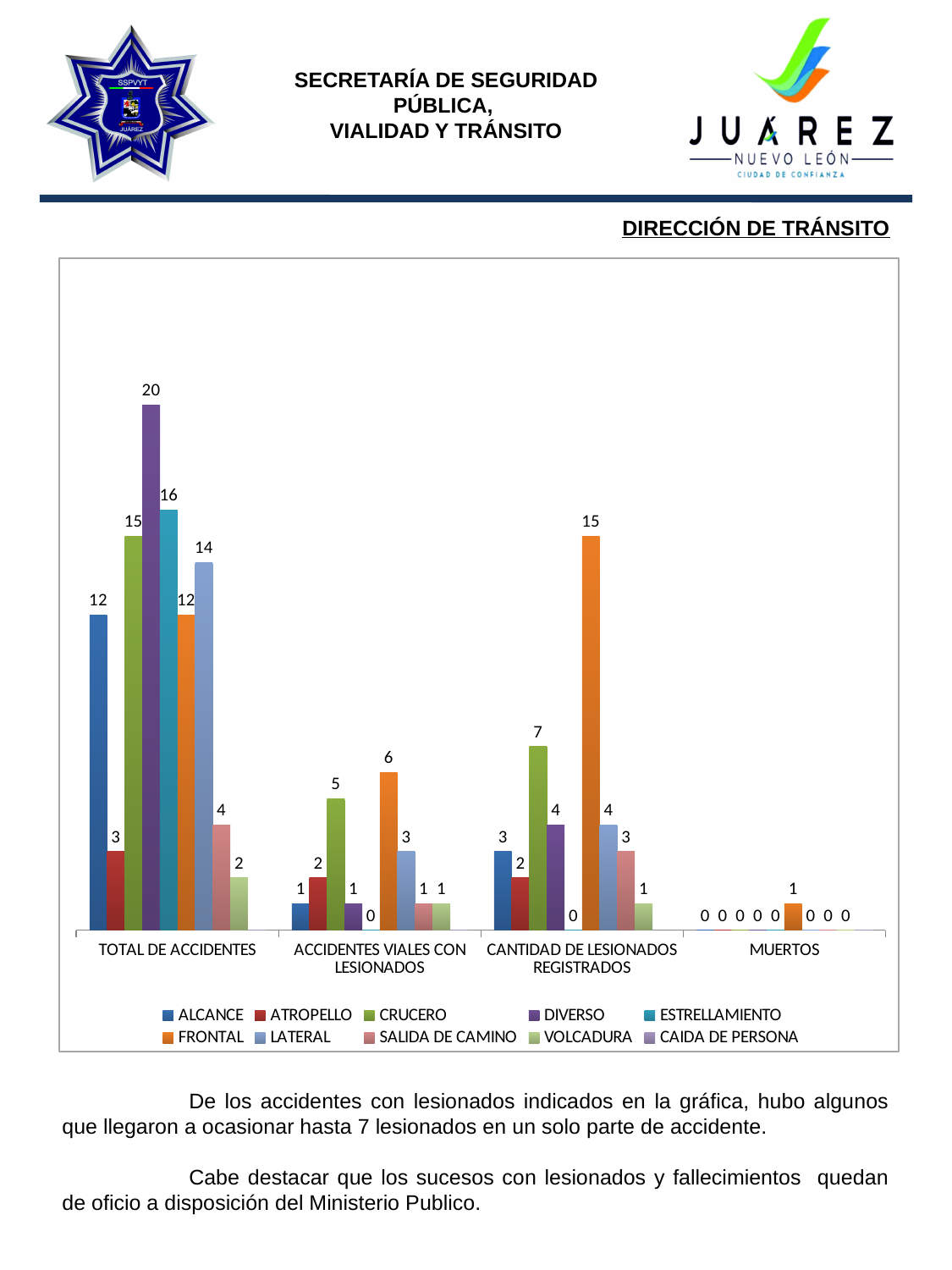
Which series has a value of 1 in the MUERTOS category? FRONTAL How many categories are shown on the x axis? 4 In the CANTIDAD DE LESIONADOS REGISTRADOS category, which is larger: CRUCERO or DIVERSO? CRUCERO What type of chart is shown on the slide? bar chart What is the value for FRONTAL in the CANTIDAD DE LESIONADOS REGISTRADOS category? 15 How many series does the legend list? 10 What is the difference between ESTRELLAMIENTO and ALCANCE in the TOTAL DE ACCIDENTES category? 4 Which series has the highest value in the TOTAL DE ACCIDENTES category? DIVERSO What is the value for DIVERSO in the TOTAL DE ACCIDENTES category? 20 What is the value for CRUCERO in the ACCIDENTES VIALES CON LESIONADOS category? 5 What is the value for LATERAL in the TOTAL DE ACCIDENTES category? 14 Which series has the highest value in the ACCIDENTES VIALES CON LESIONADOS category? FRONTAL